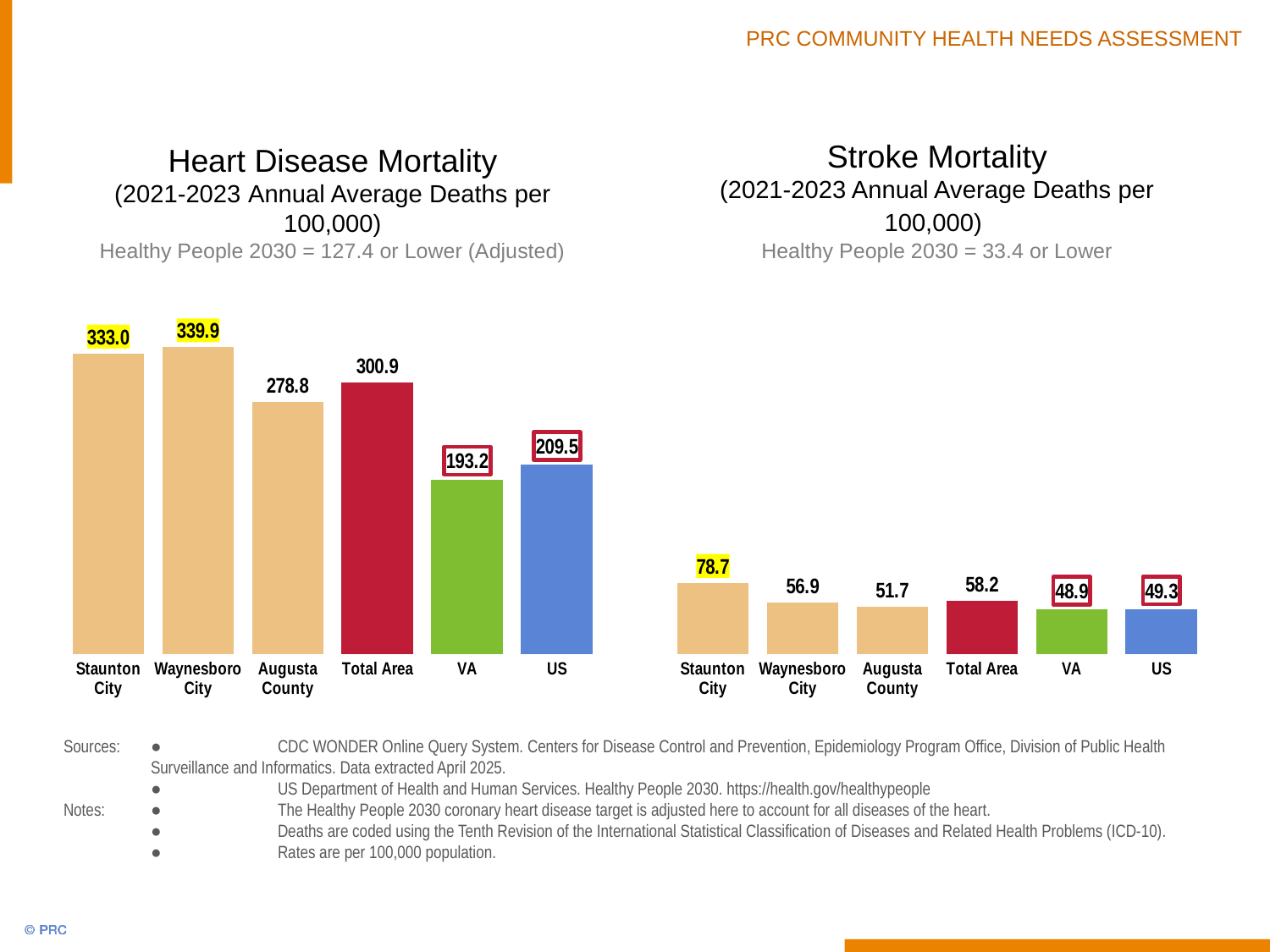
In the Heart Disease Mortality chart, what is the value for VA? 193.2 In the Stroke Mortality chart, what is the difference between the Staunton City value and the Augusta County value? 27.0 In the Stroke Mortality chart, which is larger, the value for Waynesboro City or the value for Augusta County? Waynesboro City What kind of chart is the Heart Disease Mortality chart? Bar chart In the Heart Disease Mortality chart, which category has the highest value? Waynesboro City In the Stroke Mortality chart, what is the value for Staunton City? 78.7 In the Heart Disease Mortality chart, what is the value for Waynesboro City? 339.9 In the Stroke Mortality chart, what is the value for Total Area? 58.2 In the Heart Disease Mortality chart, which category has the lowest value? VA In the Stroke Mortality chart, which category has the lowest value? VA In the Heart Disease Mortality chart, what is the difference between the Total Area value and the US value? 91.4 How many categories are shown in the Stroke Mortality chart? 6